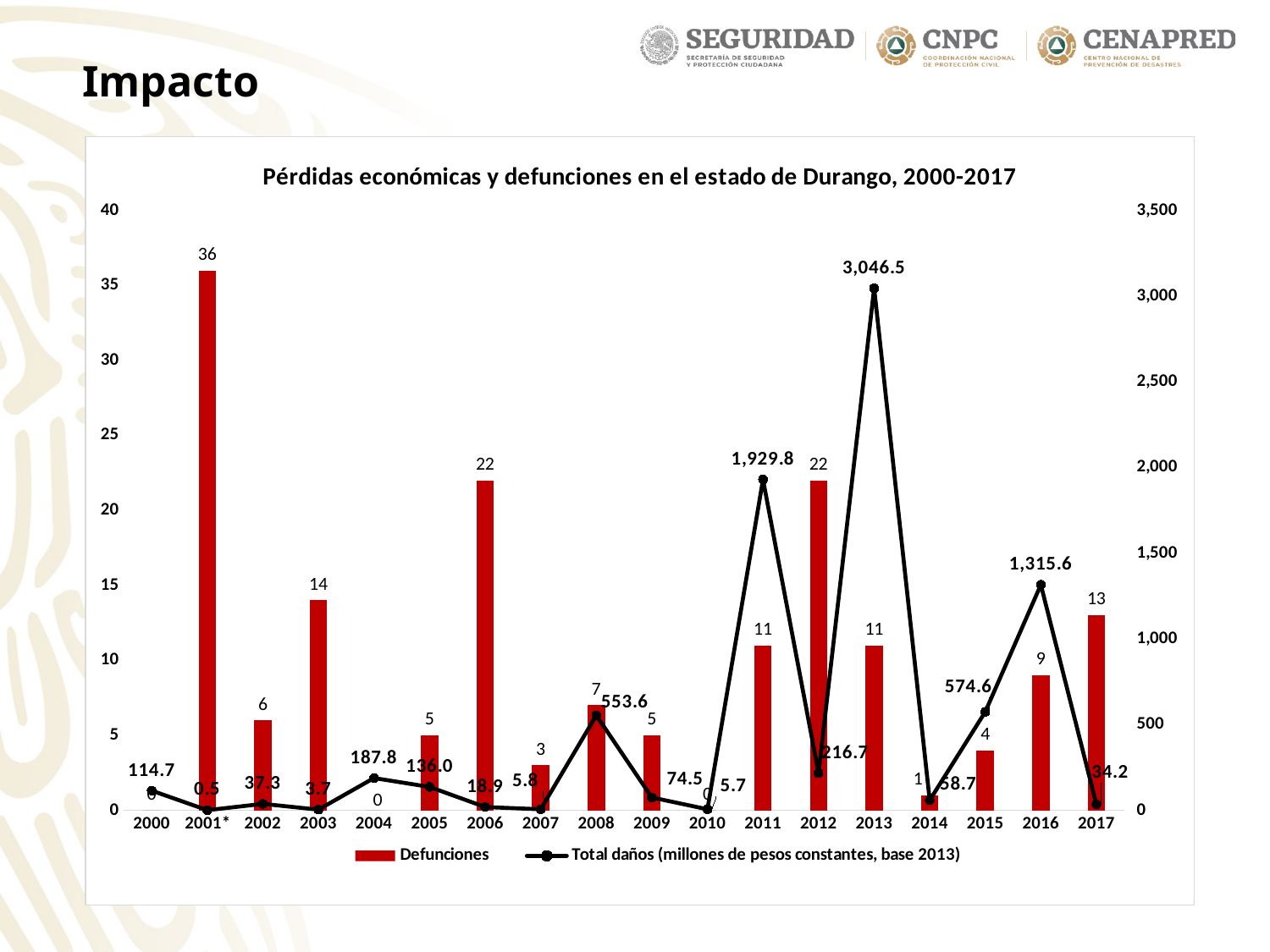
How many years are shown on the x axis? 18 What is the value of Defunciones for 2001*? 36 What is the difference in Defunciones between 2006 and 2003? 8 How many series does the legend list? 2 Which is larger, the Total daños value for 2016 or for 2015? 2016 What is the value of Total daños for 2011? 1,929.8 What is the value of Total daños (millones de pesos constantes, base 2013) for 2013? 3,046.5 Which year has the highest value of Total daños? 2013 Which year has the highest value of Defunciones? 2001* What is the title of the chart? Pérdidas económicas y defunciones en el estado de Durango, 2000-2017 What kind of chart is used to show Defunciones? Bar chart What is the value of Defunciones for 2017? 13